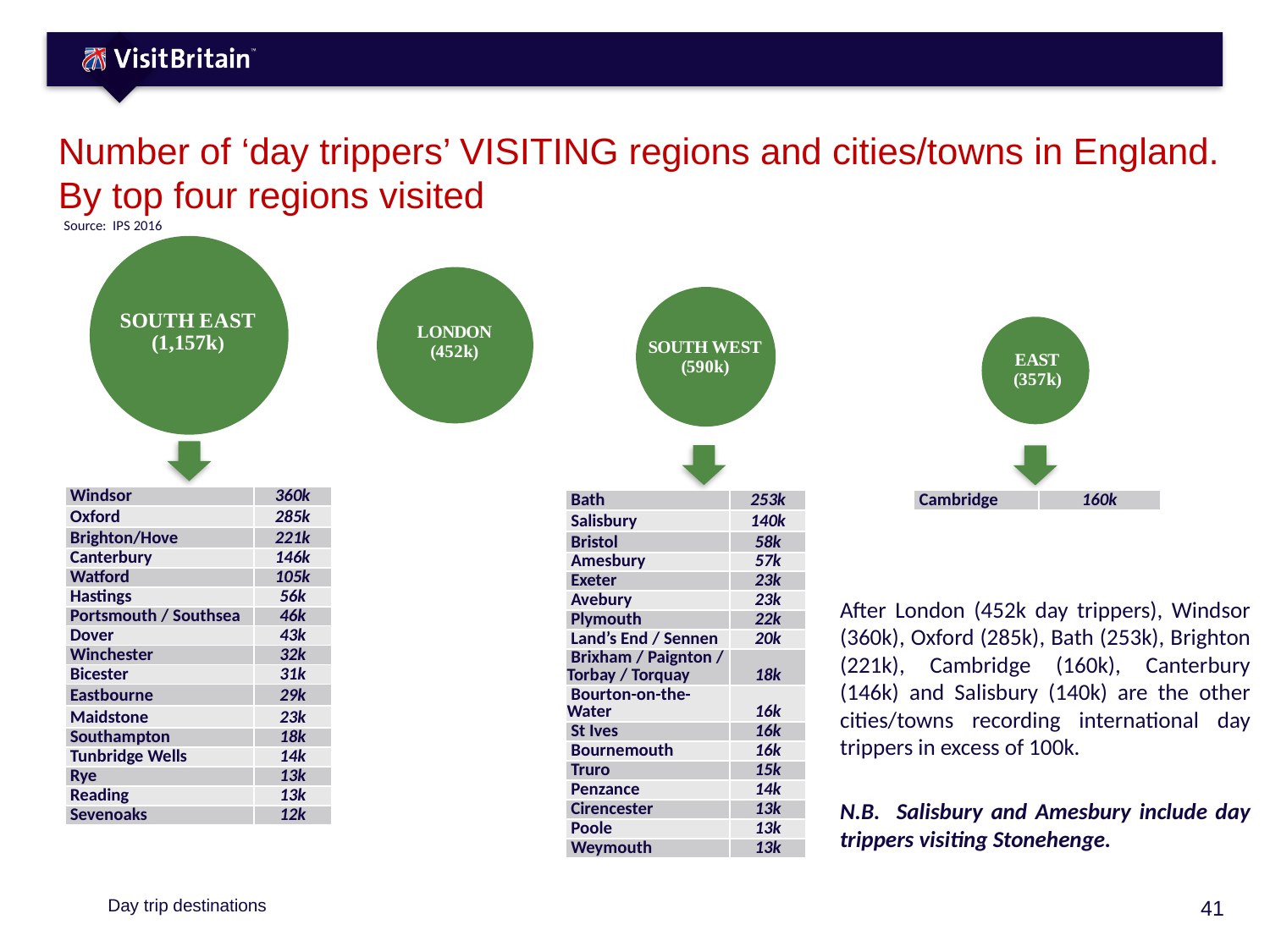
What is the difference in day trippers between the South West and London bubbles? 138k What is the source cited for the data on the slide? IPS 2016 What is the number of day trippers shown for the South East bubble? 1,157k What is the number of day trippers shown for the South West bubble? 590k What colour are the region bubbles on the slide? Green Which region has the largest bubble (most day trippers)? South East How many regions are shown as bubbles on the slide? 4 Which has more day trippers, London or the South West? South West Which region has the smallest bubble (fewest day trippers)? East What is the difference in day trippers between the South East and East bubbles? 800k What is the number of day trippers shown for the London bubble? 452k What is the number of day trippers shown for the East bubble? 357k